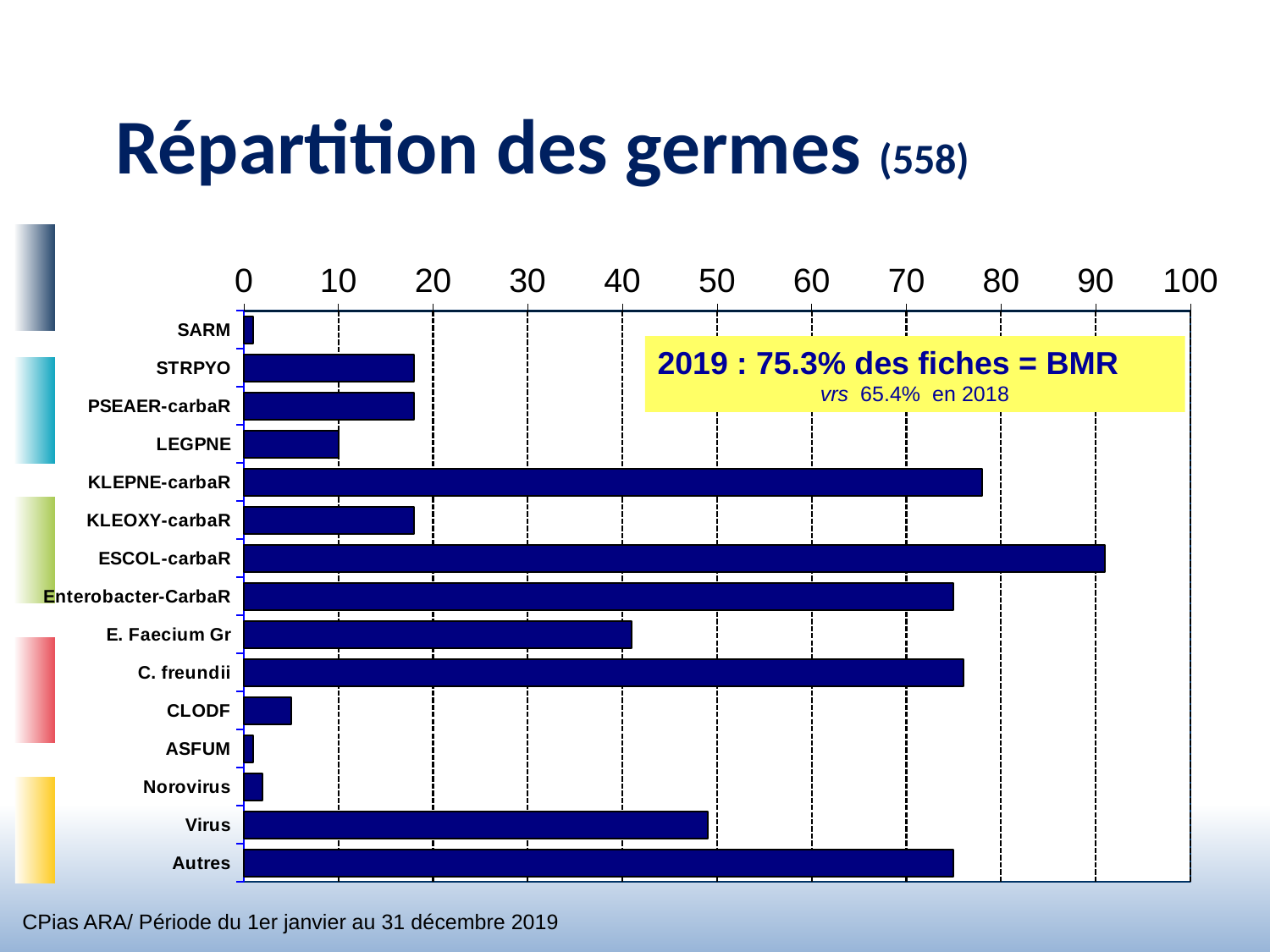
Which is larger, the value for KLEPNE-carbaR or the value for E. Faecium Gr? KLEPNE-carbaR Which category has the highest value on the chart? ESCOL-carbaR Which is larger, the value for Autres or the value for Virus? Autres Is the value for E. Faecium Gr greater or less than 50? less What kind of chart is shown on the slide? bar chart Is the value for Virus greater or less than 40? greater Is the value for CLODF greater or less than 10? less According to the yellow text box on the chart, what percentage of the 2019 fiches were BMR? 75.3% How many categories (germs) are plotted on the chart? 15 What is the title of the slide containing the chart? Répartition des germes (558)